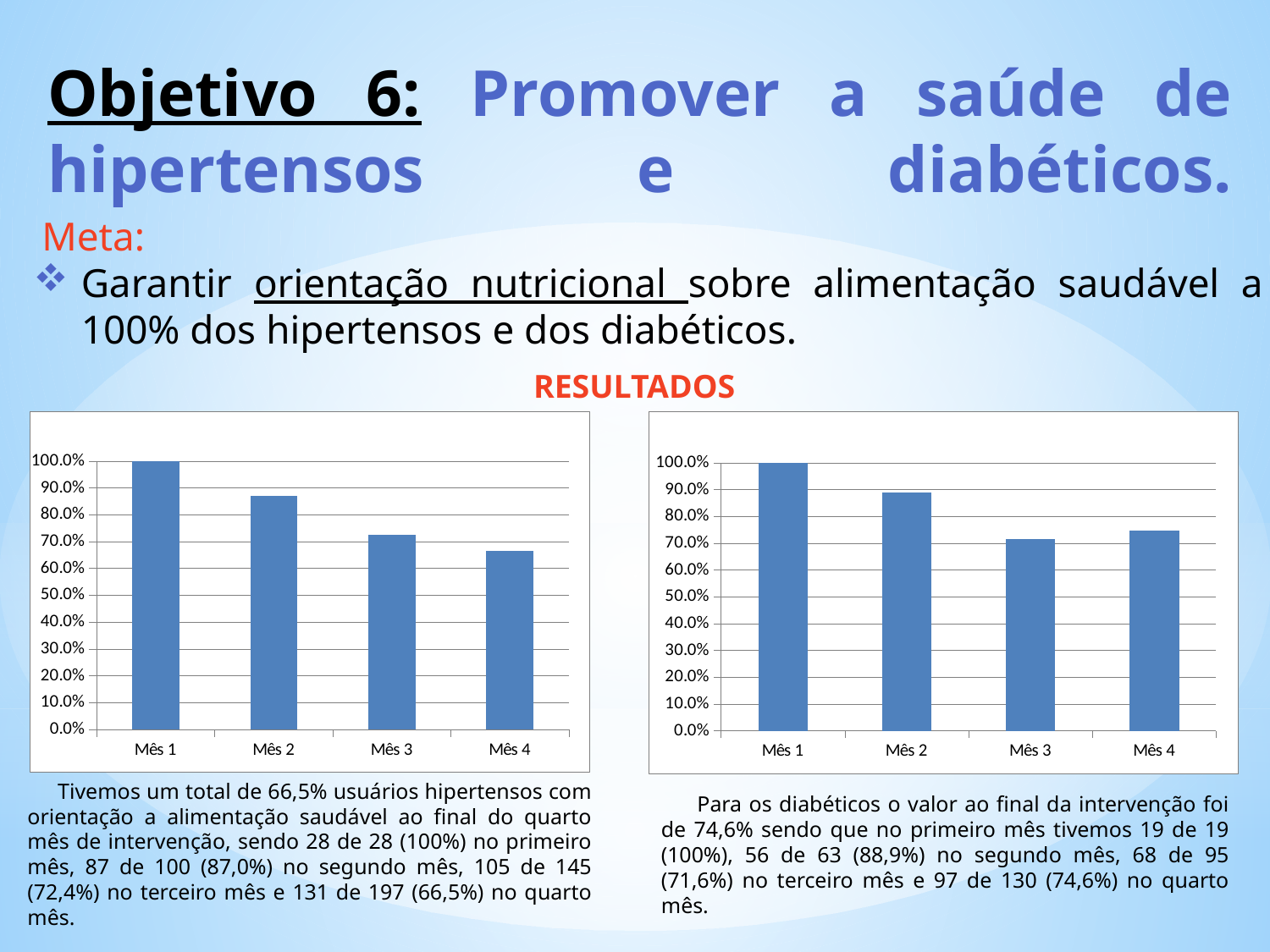
In the left chart, is the value for Mês 2 greater or less than 80.0%? greater In the left chart, which month has the lowest value? Mês 4 In the left chart, is the value for Mês 4 greater or less than 70.0%? less What kind of chart is the left chart on the slide? bar chart How many categories are shown on the x axis of the right chart? 4 In the right chart, which is larger, the value for Mês 3 or the value for Mês 4? Mês 4 In the right chart, what is the value for Mês 1? 100.0% In the right chart, is the value for Mês 3 greater or less than 80.0%? less In the left chart, do the values rise or fall from Mês 1 to Mês 4? fall In the left chart, what is the value for Mês 1? 100.0% In the left chart, which month has the highest value? Mês 1 How many categories are shown on the x axis of the left chart? 4